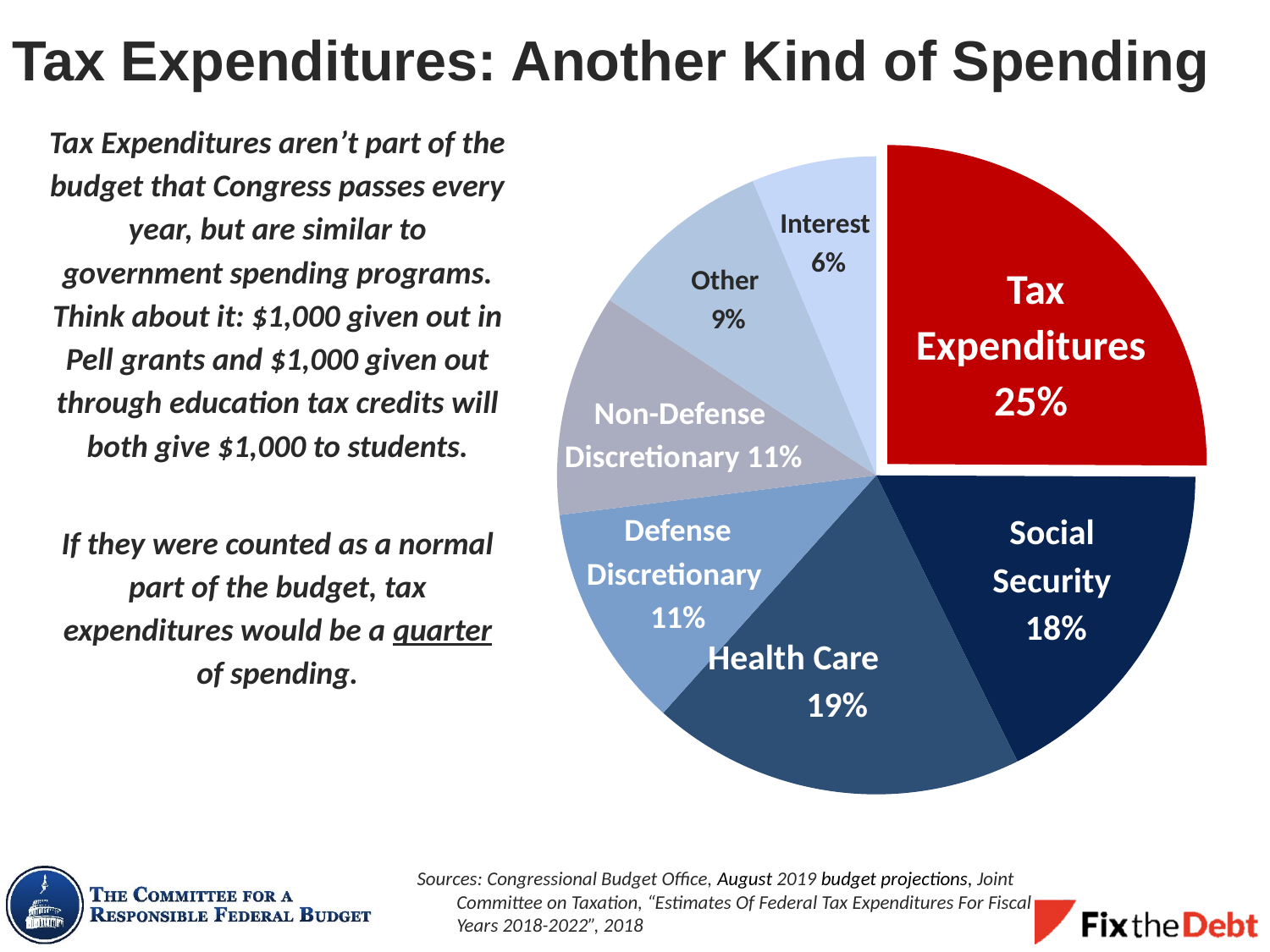
What percentage is shown for Social Security? 18% What colour is the Tax Expenditures slice? Red Which is larger, Other or Interest? Other What kind of chart is shown on the slide? Pie chart Which slice of the pie is the largest? Tax Expenditures How many slices does the pie chart have? 7 What percentage is shown for Health Care? 19% What share of spending does the Tax Expenditures slice represent? 25% What is the difference in percentage points between Tax Expenditures and Social Security? 7 What percentage is shown for Interest? 6% What is the combined share of Defense Discretionary and Non-Defense Discretionary? 22% Which slice of the pie is the smallest? Interest